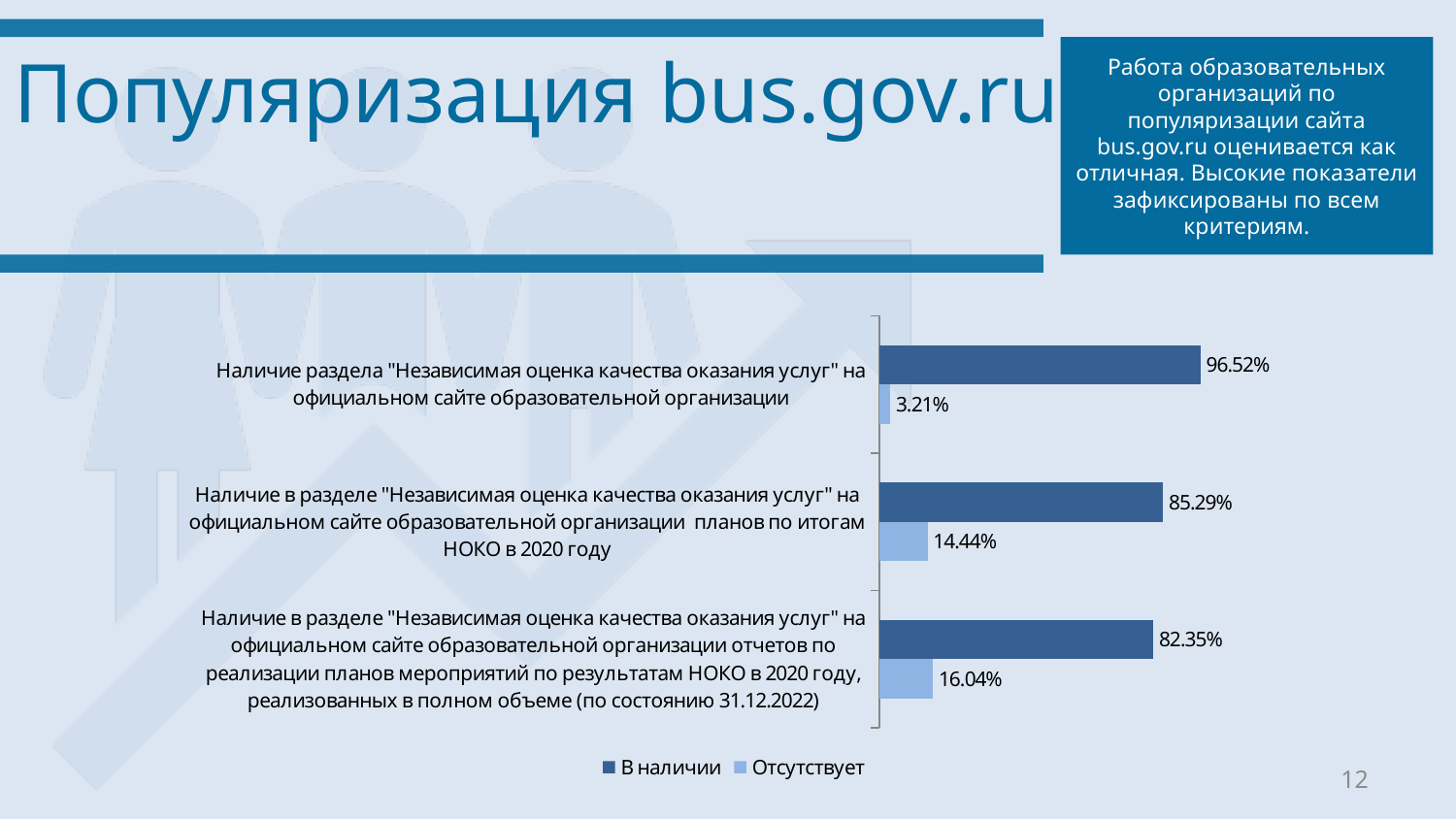
What is the value of "В наличии" for the category about отчетов по реализации планов мероприятий по результатам НОКО в 2020 году? 82.35% How many series does the chart legend list? 2 What type of chart is shown on the slide? bar chart What is the value of "Отсутствует" for the category "Наличие раздела "Независимая оценка качества оказания услуг" на официальном сайте образовательной организации"? 3.21% Which is larger: the "Отсутствует" value for the category about планов по итогам НОКО в 2020 году or for the category about отчетов по реализации планов мероприятий? отчетов по реализации планов мероприятий (16.04%) What is the value of "В наличии" for the category "Наличие раздела "Независимая оценка качества оказания услуг" на официальном сайте образовательной организации"? 96.52% What are the two legend entries of the chart? В наличии, Отсутствует Which category has the lowest "Отсутствует" value? Наличие раздела "Независимая оценка качества оказания услуг" на официальном сайте образовательной организации Which category has the highest "В наличии" value? Наличие раздела "Независимая оценка качества оказания услуг" на официальном сайте образовательной организации How many categories are plotted in the chart? 3 What is the value of "Отсутствует" for the category about планов по итогам НОКО в 2020 году? 14.44% What is the difference between the "В наличии" values for the first category (96.52%) and the category about планов по итогам НОКО в 2020 году (85.29%)? 11.23%